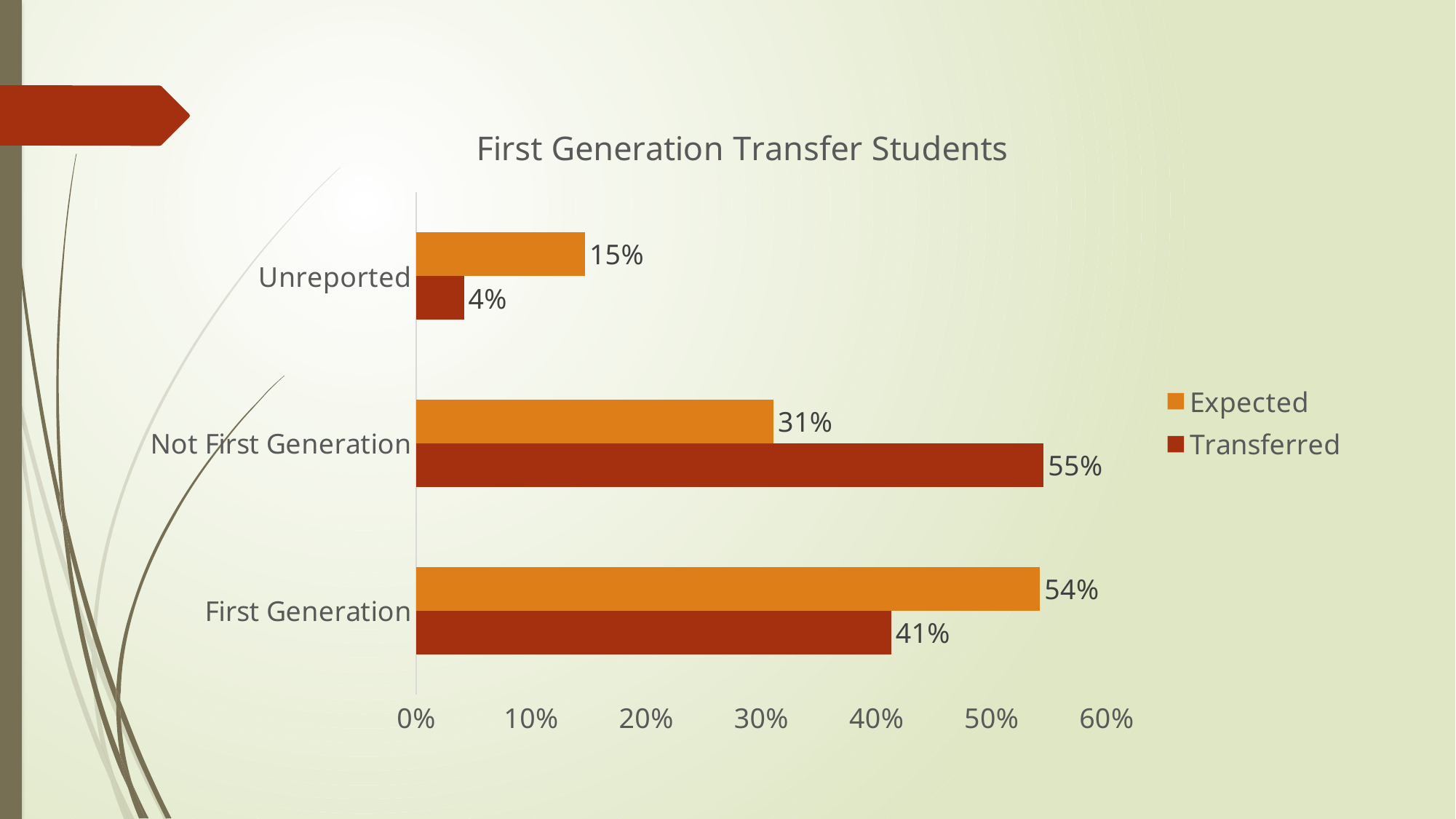
Which category has the highest Transferred value? Not First Generation What is the difference between the Expected and Transferred values for Not First Generation? 24% Which category has the lowest Expected value? Unreported How many series does the legend list? 2 What is the Transferred value for Unreported? 4% What is the difference between the Expected and Transferred values for Unreported? 11% Which is larger for First Generation, the Expected value or the Transferred value? Expected How many categories are shown on the chart? 3 What is the Expected value for First Generation? 54% What kind of chart is shown on the slide? Bar chart What is the Expected value for Unreported? 15% What is the Transferred value for Not First Generation? 55%